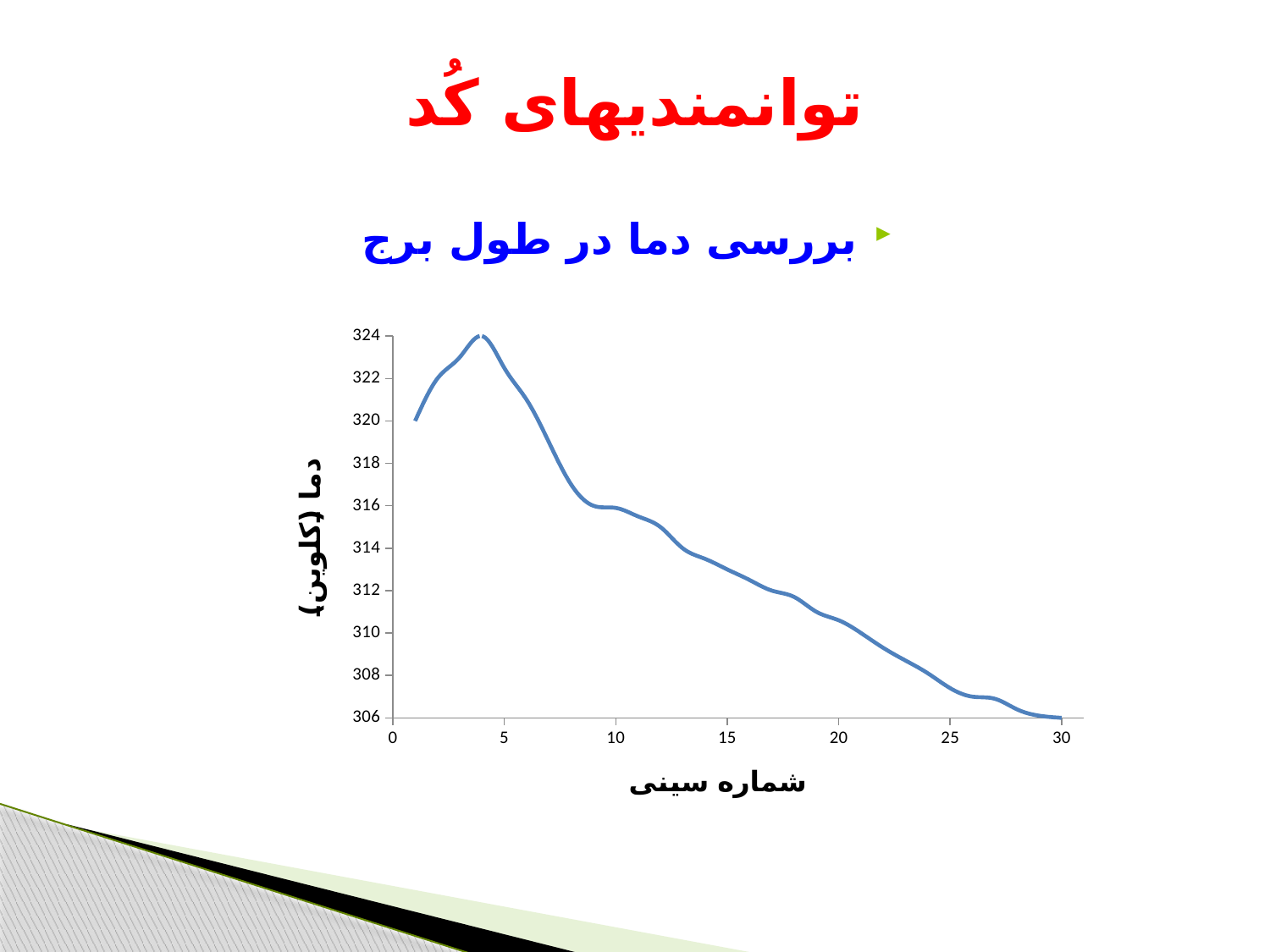
Is the temperature at tray number 25 greater or less than 306? greater Which is larger, the temperature at tray number 10 or at tray number 20? tray number 10 Is the temperature at tray number 1 greater or less than 318? greater Is the temperature at tray number 20 greater or less than 312? less What kind of chart is shown on the slide? line chart Does the temperature generally rise or fall from tray number 5 to tray number 30? fall What is the label of the x axis of the chart? شماره سینی What is the label of the y axis of the chart? دما (کلوین) Around which tray number does the temperature reach its highest value? 4